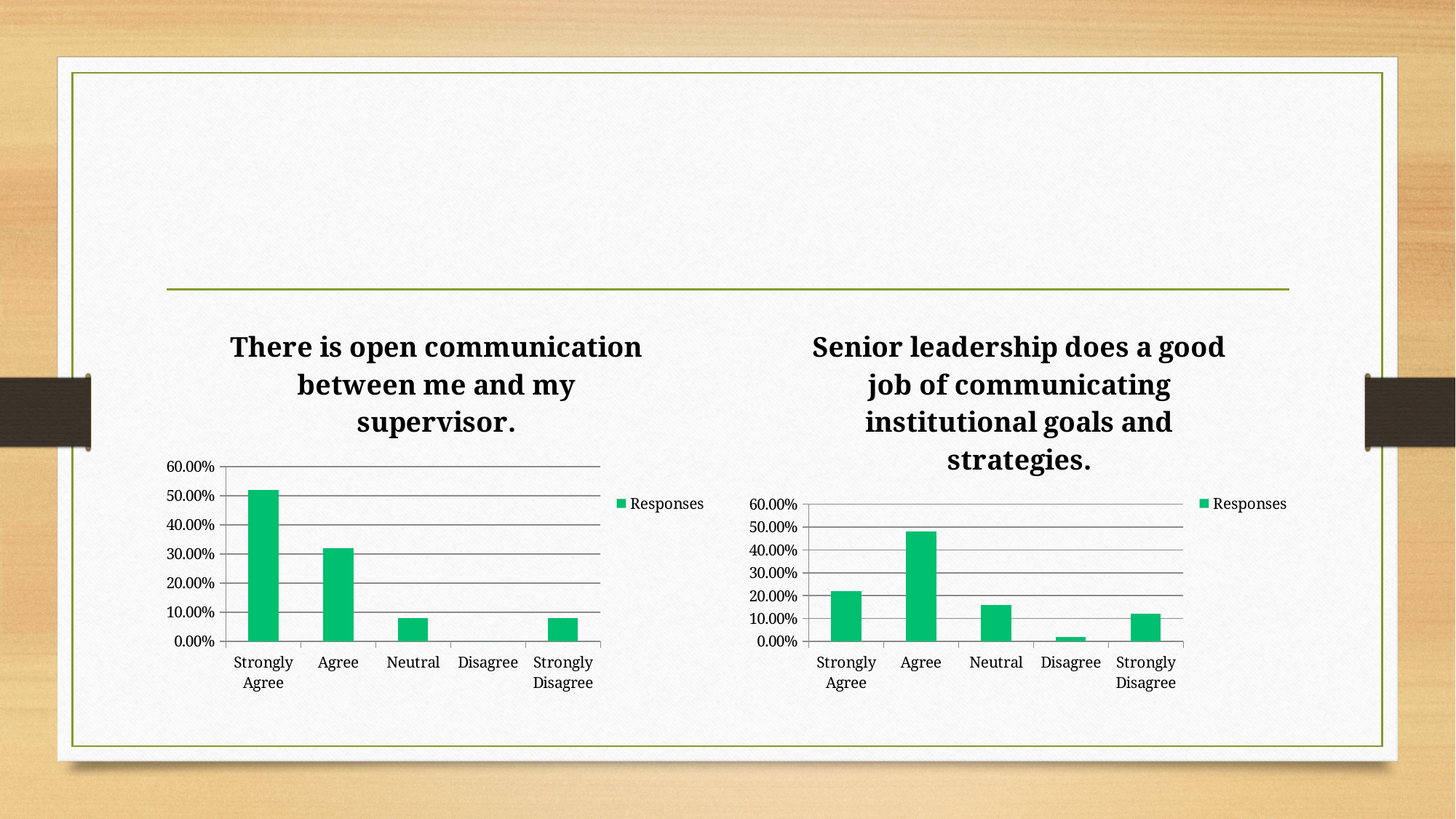
How many series does the legend of the right chart (senior leadership communicating institutional goals) list? 1 In the left chart (open communication with supervisor), is the value for Agree greater or less than 40.00%? less What kind of chart is used on the left, titled "There is open communication between me and my supervisor."? bar chart In the left chart (open communication with supervisor), which category has the lowest value? Disagree In the right chart (senior leadership communicating institutional goals), which category has the lowest value? Disagree In the right chart (senior leadership communicating institutional goals), which category has the highest value? Agree In the right chart (senior leadership communicating institutional goals), which is larger, the value for Neutral or the value for Strongly Disagree? Neutral In the left chart (open communication with supervisor), which category has the highest value? Strongly Agree In the right chart (senior leadership communicating institutional goals), is the value for Agree greater or less than 40.00%? greater In the left chart (open communication with supervisor), is the value for Strongly Agree greater or less than 50.00%? greater How many categories are shown on the x axis of the left chart (open communication with supervisor)? 5 In the left chart (open communication with supervisor), which is larger, the value for Strongly Agree or the value for Agree? Strongly Agree